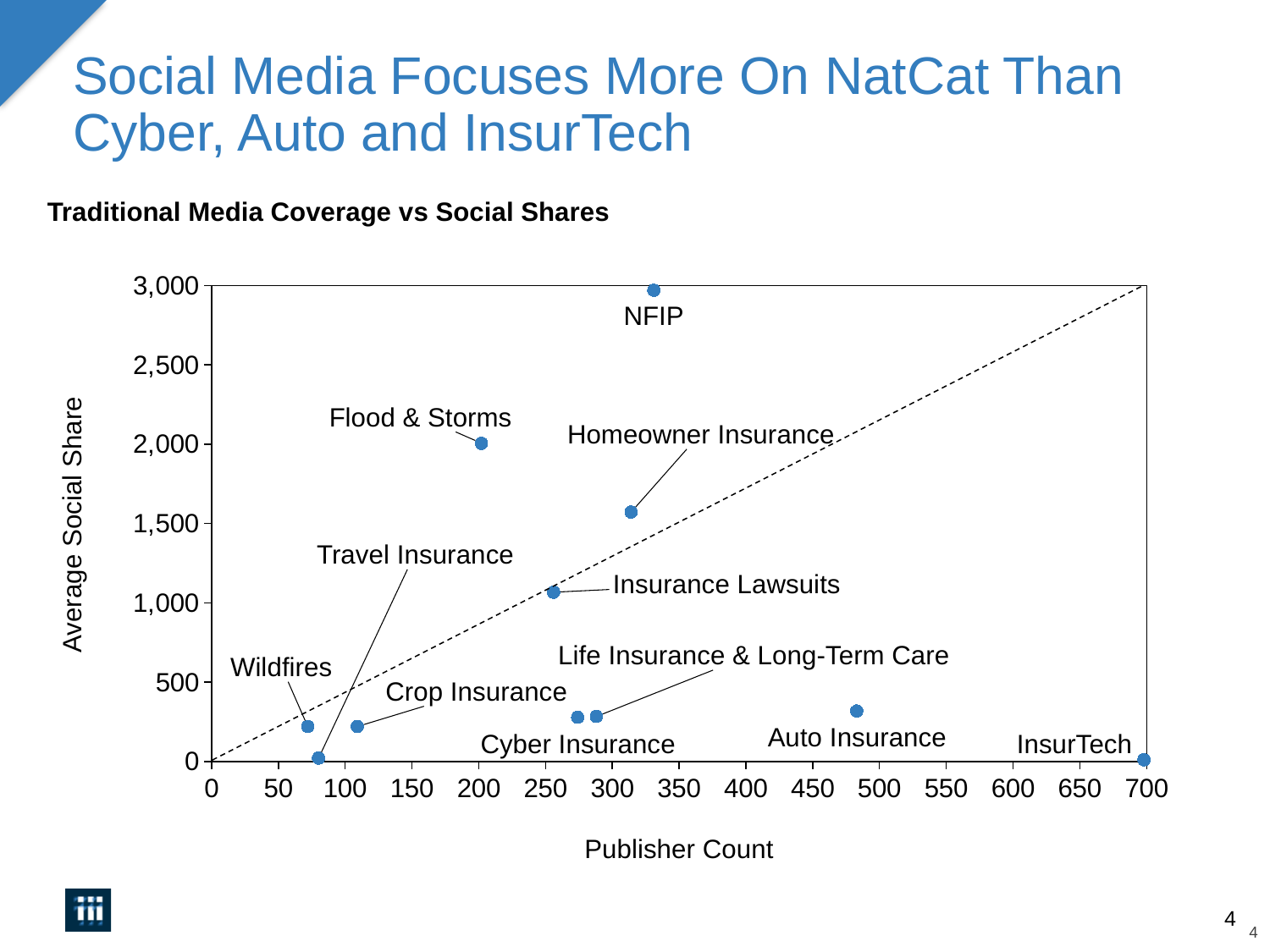
What is the title of the chart? Traditional Media Coverage vs Social Shares What kind of chart is shown on the slide? Scatter chart Is the Average Social Share for NFIP greater or less than 2,500? greater Is the Average Social Share for Cyber Insurance greater or less than 500? less How many labeled data points are plotted on the chart? 11 What is the label of the x axis? Publisher Count Is the Publisher Count for Auto Insurance greater or less than 400? greater Which category has the highest Average Social Share? NFIP Which category has the highest Publisher Count? InsurTech Which has a higher Publisher Count, Auto Insurance or Cyber Insurance? Auto Insurance Which has a higher Average Social Share, Flood & Storms or Homeowner Insurance? Flood & Storms